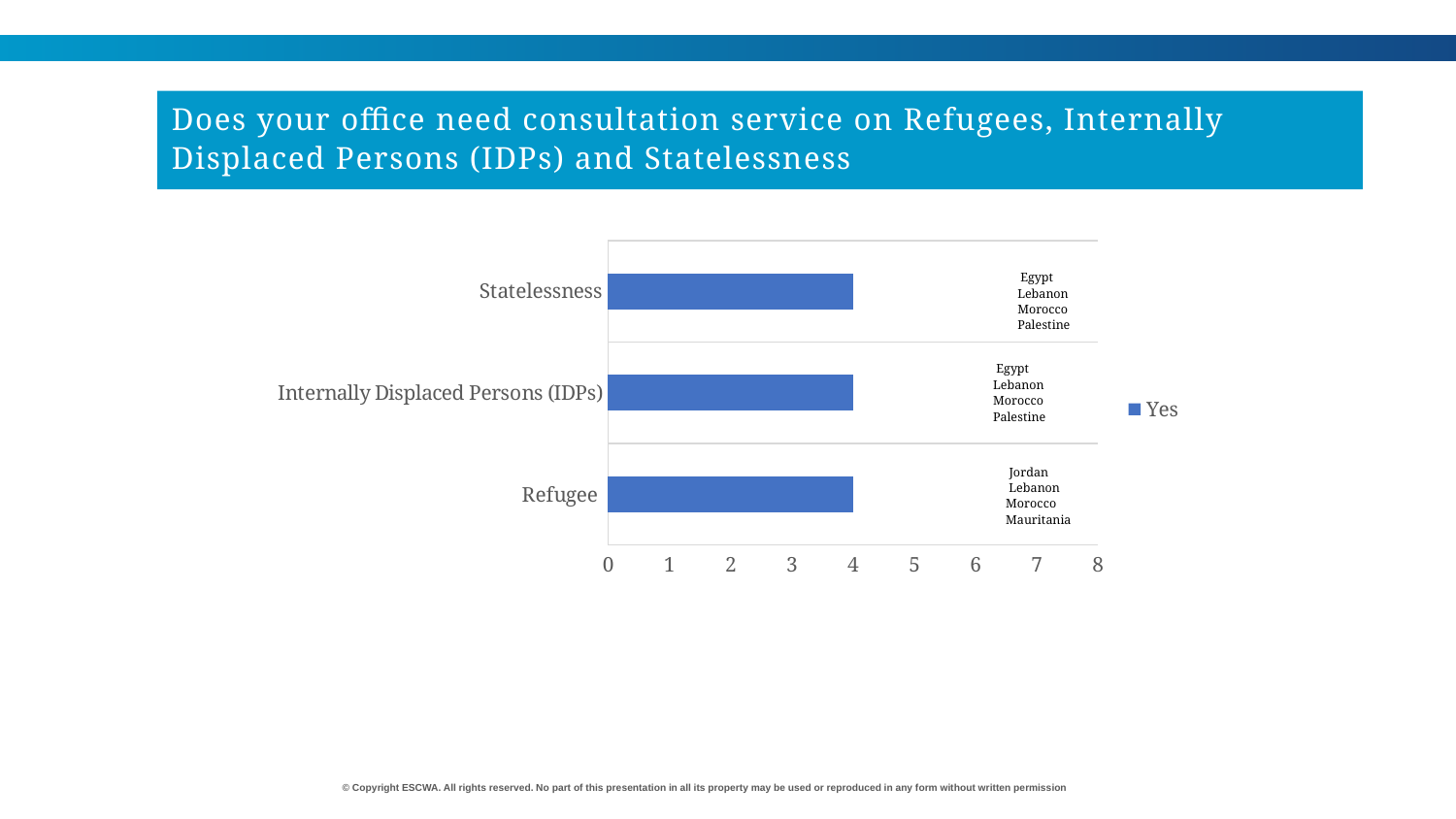
What is the value for Refugee? 4 What is the name of the series listed in the legend? Yes What is the value for Statelessness? 4 What kind of chart is shown on the slide? Bar chart Is the value for Statelessness greater or less than 2? greater How many categories are shown on the chart? 3 What is the value for Internally Displaced Persons (IDPs)? 4 What is the highest value shown on the x axis? 8 Is the value for Refugee greater or less than 6? less What is the difference between the values for Statelessness and Refugee? 0 How many series does the legend list? 1